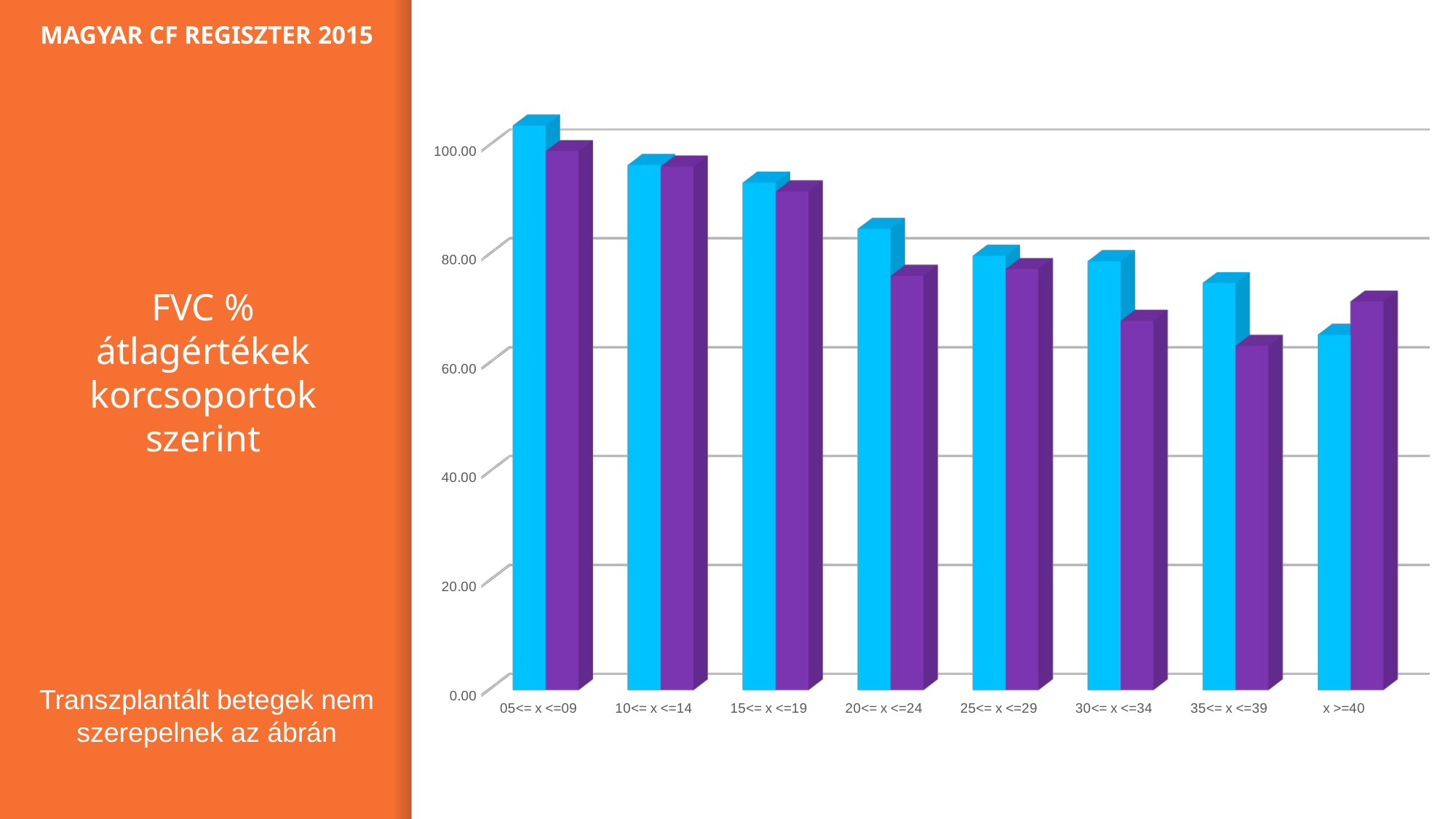
In the x >=40 age group, which bar is taller, the blue or the purple one? purple What kind of chart is shown on the slide? bar chart How many age-group categories are shown on the x axis? 8 Which age group has the highest blue bar? 05<= x <=09 Is the purple bar for 20<= x <=24 greater or less than 80.00? less Is the blue bar for 20<= x <=24 greater or less than 80.00? greater In the 20<= x <=24 age group, which bar is taller, the blue or the purple one? blue Do the blue bars rise or fall as the age groups increase along the x axis? fall Which age group has the lowest blue bar? x >=40 Is the blue bar for x >=40 greater or less than 80.00? less Which age group has the lowest purple bar? 35<= x <=39